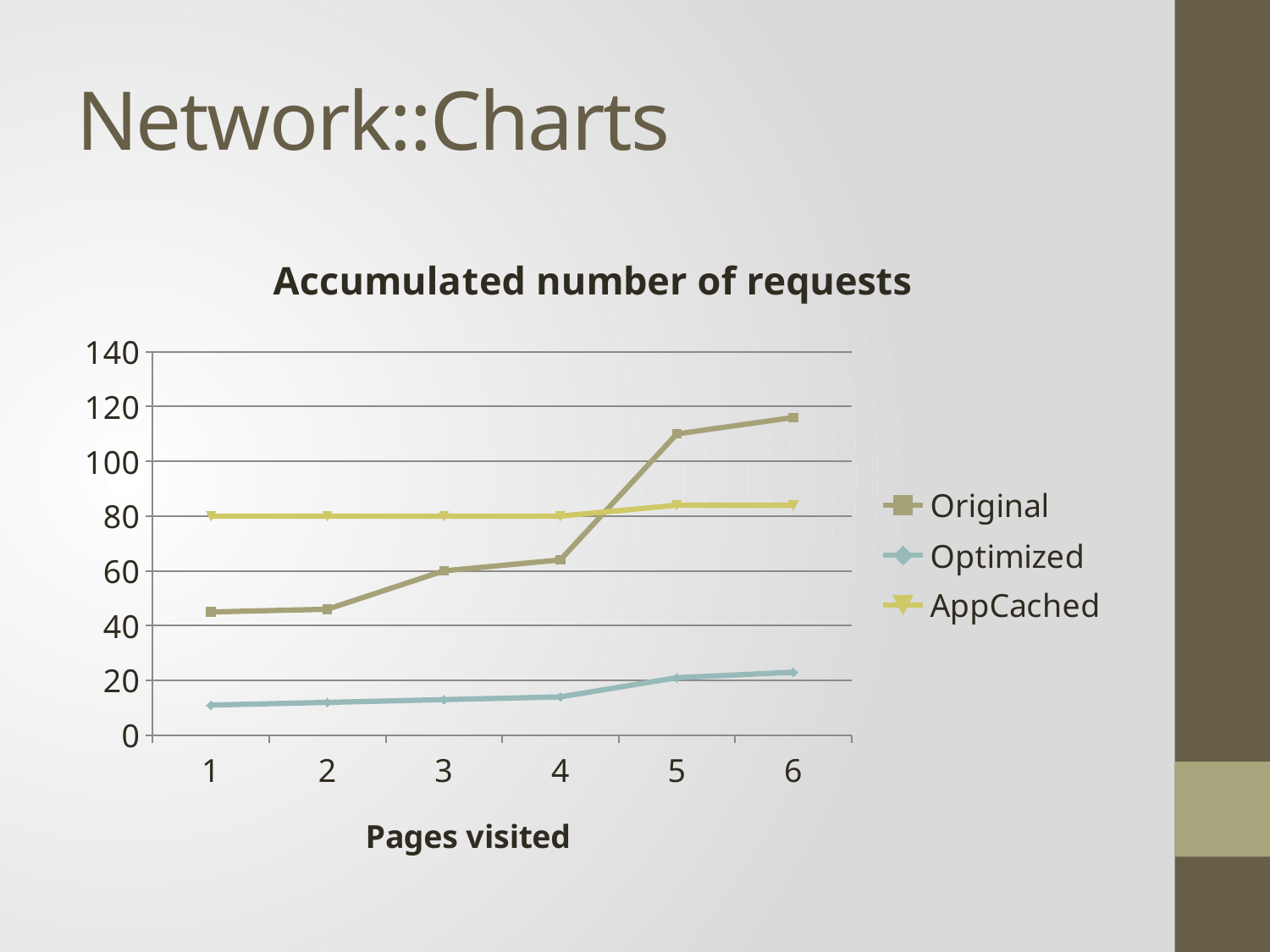
At page 1, which is larger: Original or AppCached? AppCached How many points along the x axis (pages visited) does each series have? 6 Is the value for Original at page 6 greater or less than 100? greater How many series does the legend list? 3 What is the label of the x axis? Pages visited At page 6, which is larger: Original or AppCached? Original Is the value for Optimized at page 6 greater or less than 40? less What kind of chart is shown on the slide? line chart What is the title of the chart? Accumulated number of requests At page 1, which series has the lowest value? Optimized Does the Original series rise or fall as the number of pages visited increases? rise At page 6, which series has the highest value? Original